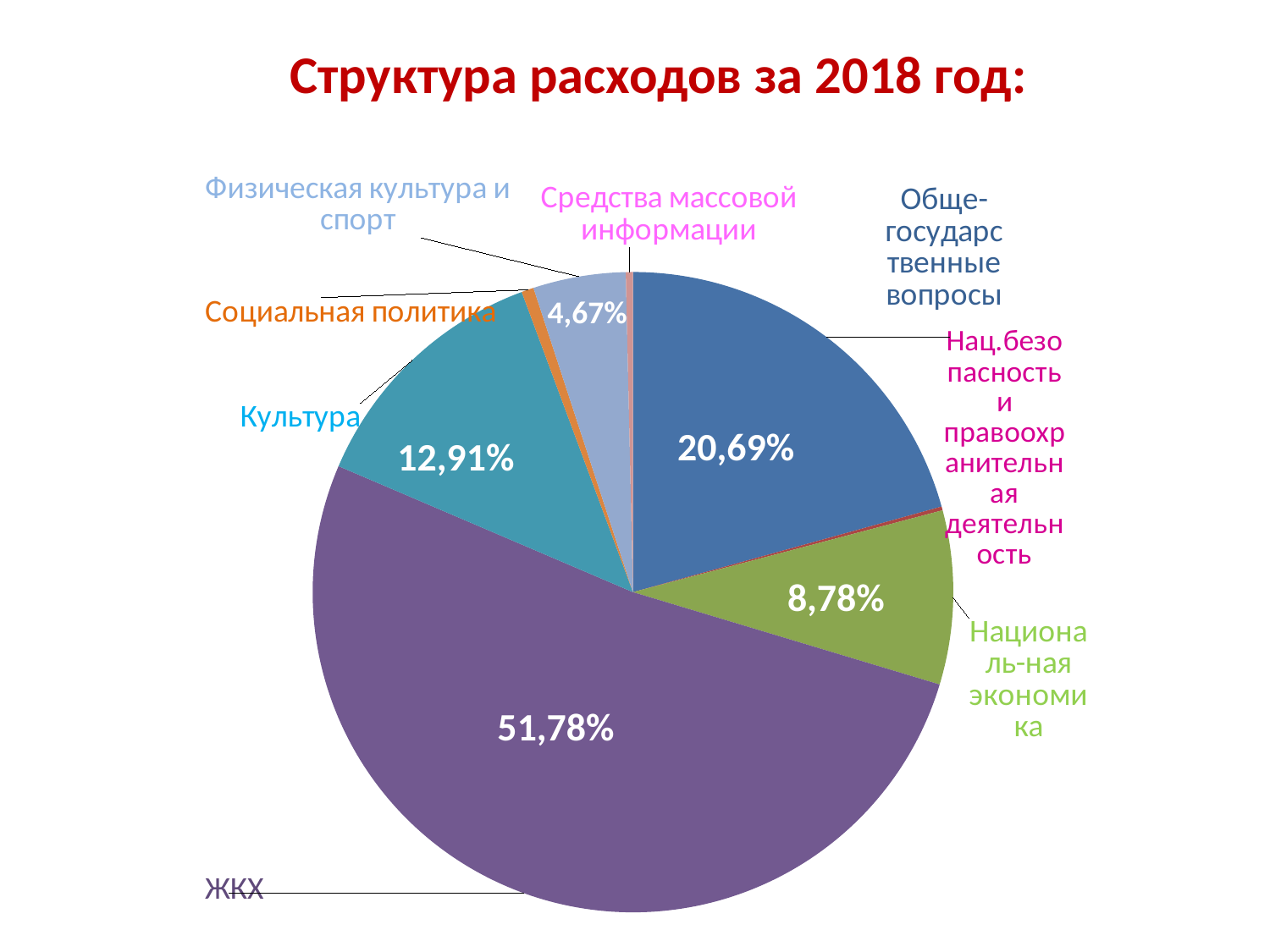
What kind of chart is shown on the slide? Pie chart What is the title of the chart? Структура расходов за 2018 год: What percentage is shown for Культура? 12,91% What percentage is shown for Физическая культура и спорт? 4,67% Which is larger, Культура or Национальная экономика? Культура Which is larger, Общегосударственные вопросы or Физическая культура и спорт? Общегосударственные вопросы What is the difference between the shares of ЖКХ and Общегосударственные вопросы? 31,09% How many categories are shown in the pie chart? 8 What is the value for Национальная экономика? 8,78% What share of expenses does ЖКХ account for? 51,78% What is the value shown for Общегосударственные вопросы? 20,69% Which category has the largest share of the pie? ЖКХ